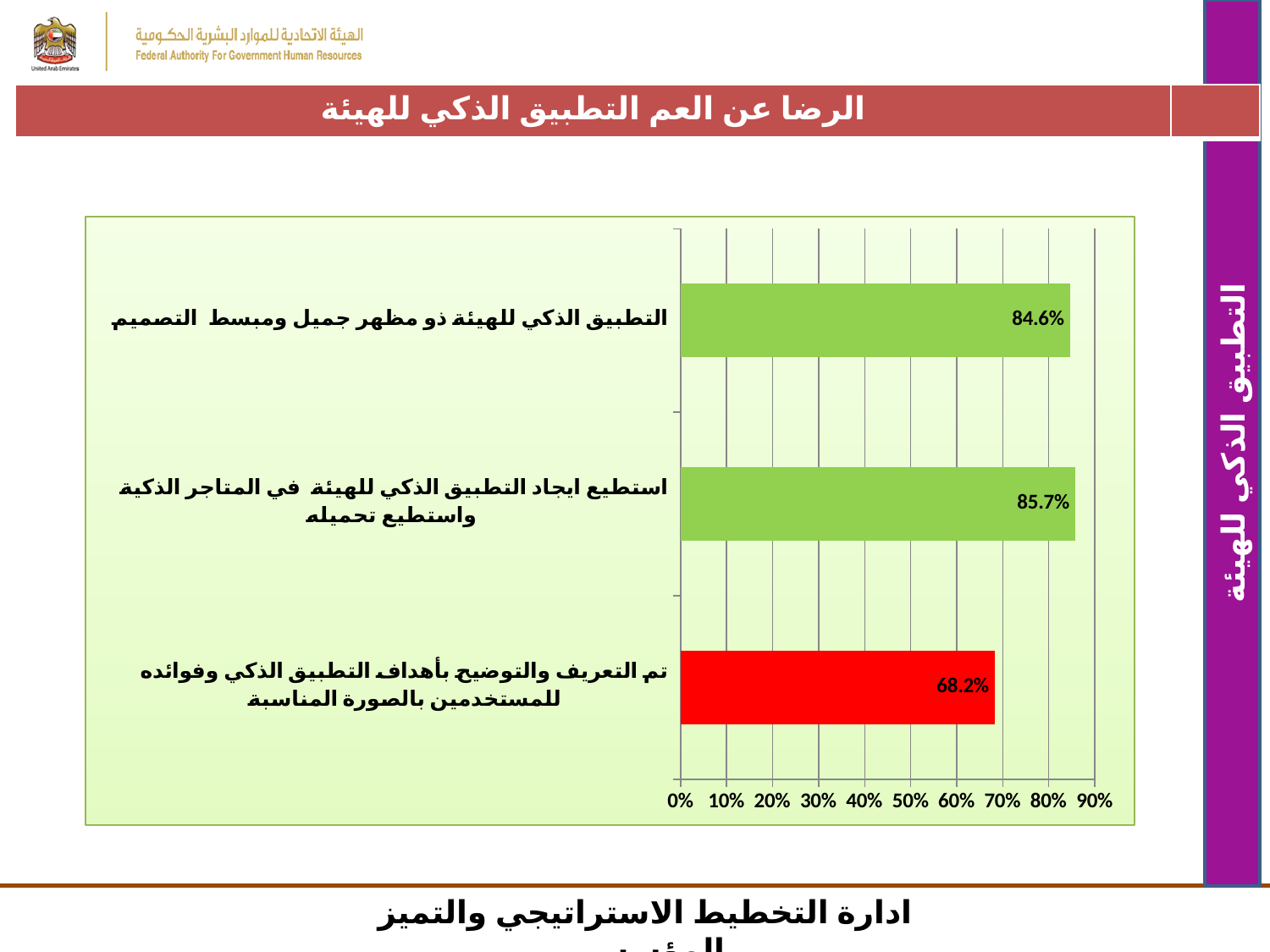
What is the difference between the highest value (85.7%) and the lowest value (68.2%)? 17.5% Which category has the highest value? استطيع ايجاد التطبيق الذكي للهيئة في المتاجر الذكية واستطيع تحميله What is the difference between the values 85.7% and 84.6%? 1.1% What is the value for the category "التطبيق الذكي للهيئة ذو مظهر جميل ومبسط التصميم"? 84.6% What kind of chart is shown on the slide? bar chart Is the value for "تم التعريف والتوضيح بأهداف التطبيق الذكي وفوائده للمستخدمين بالصورة المناسبة" greater or less than 70%? less Which category has the lowest value? تم التعريف والتوضيح بأهداف التطبيق الذكي وفوائده للمستخدمين بالصورة المناسبة What colour is the bar for the lowest category? red How many categories are shown in the chart? 3 What is the value for the category "تم التعريف والتوضيح بأهداف التطبيق الذكي وفوائده للمستخدمين بالصورة المناسبة"? 68.2% Which is larger: the value for "التطبيق الذكي للهيئة ذو مظهر جميل ومبسط التصميم" or the value for "تم التعريف والتوضيح بأهداف التطبيق الذكي وفوائده للمستخدمين بالصورة المناسبة"? التطبيق الذكي للهيئة ذو مظهر جميل ومبسط التصميم What is the value for the category "استطيع ايجاد التطبيق الذكي للهيئة في المتاجر الذكية واستطيع تحميله"? 85.7%